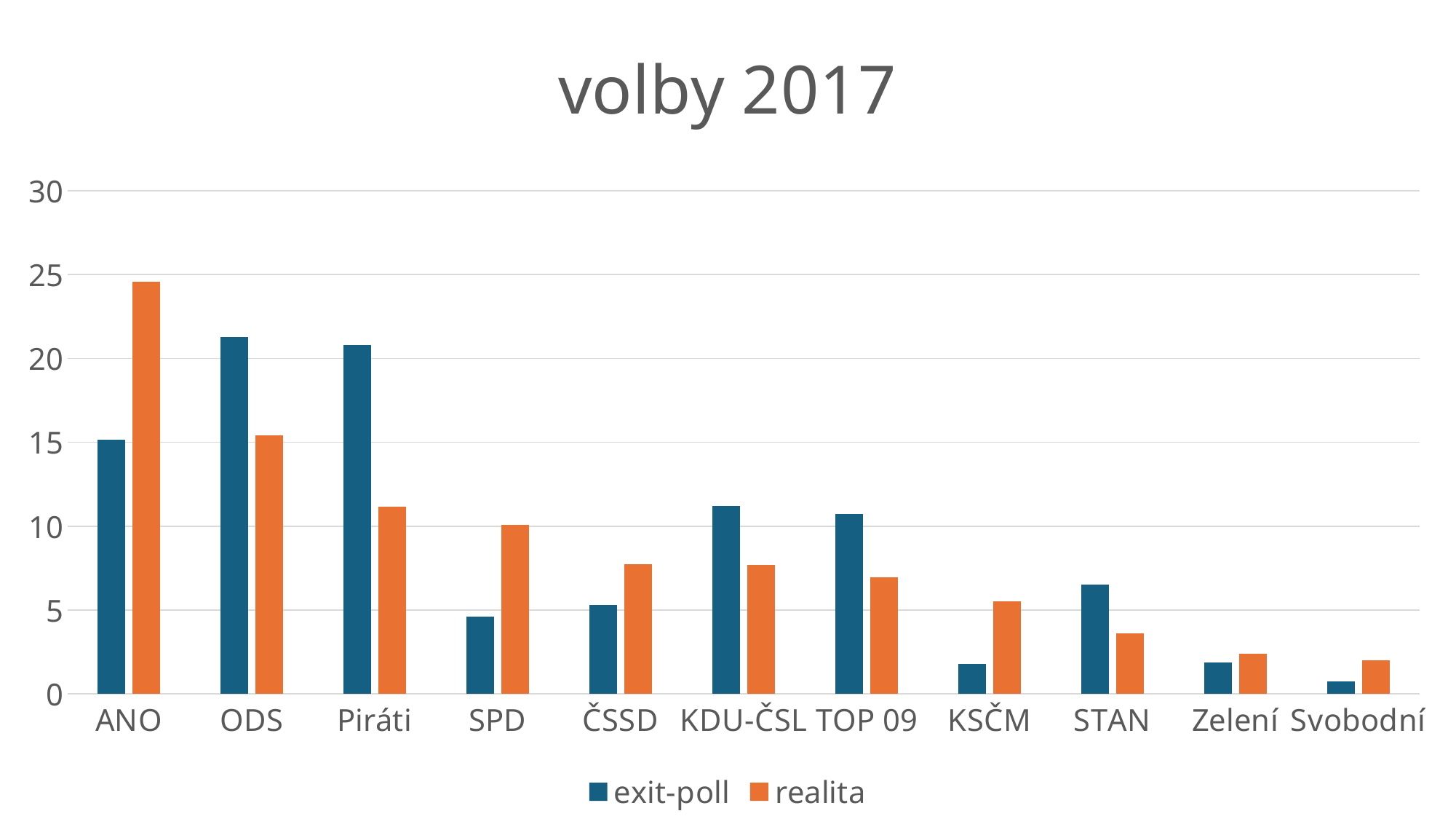
For ODS, which is larger: the exit-poll value or the realita value? exit-poll What is the title of the chart? volby 2017 Is the exit-poll value for Piráti greater or less than 20? greater Which party has the lowest exit-poll value? Svobodní How many parties (categories) are shown on the x axis? 11 Is the realita value for ANO greater or less than 20? greater For KSČM, which is larger: the exit-poll value or the realita value? realita Is the exit-poll value for SPD greater or less than 5? less Which party has the highest realita value? ANO Which colour represents the realita series? orange How many series does the legend list? 2 What kind of chart is shown on the slide? bar chart